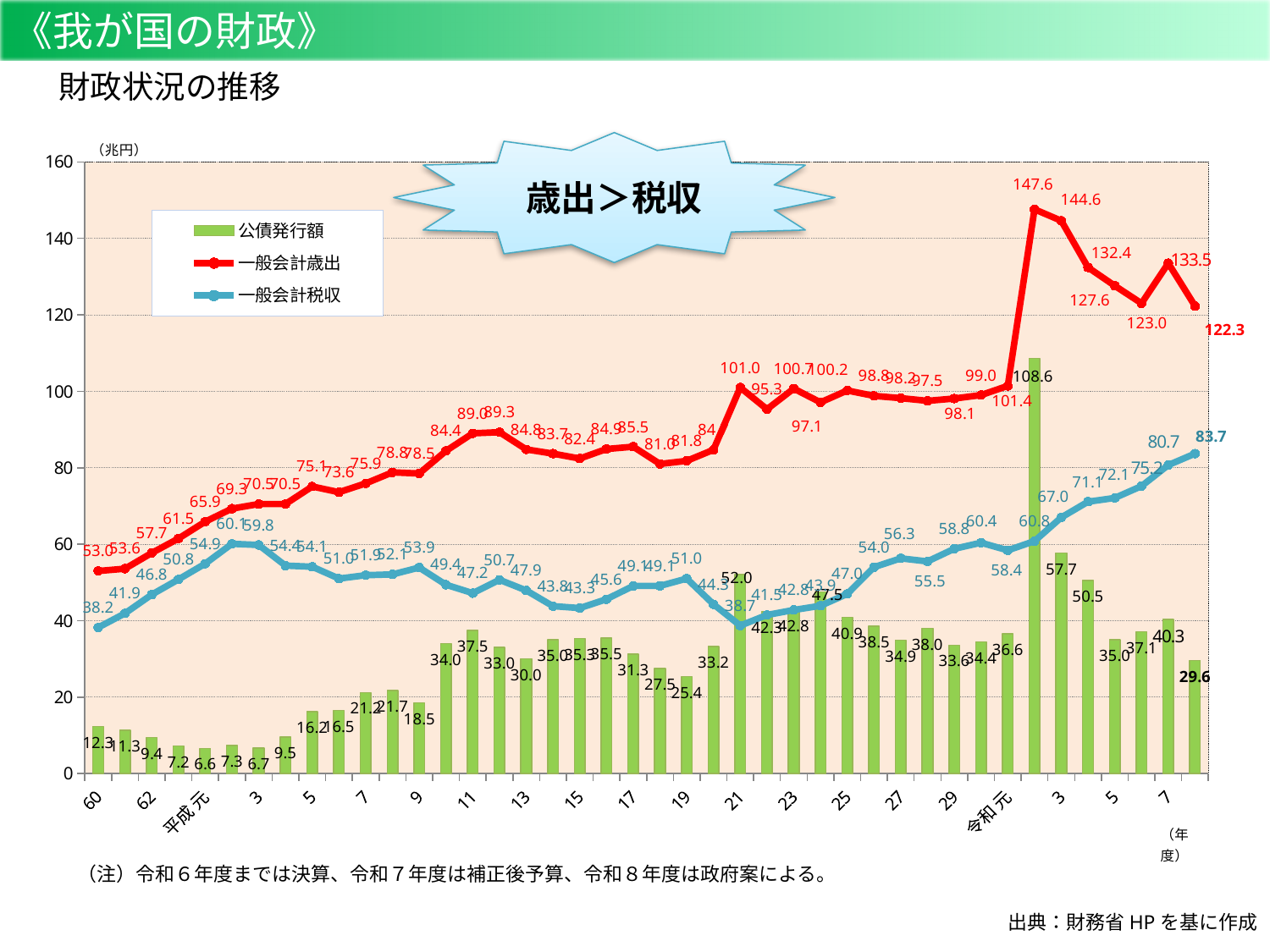
What is the highest value of 公債発行額 shown on the chart? 108.6 Does 一般会計税収 rise or fall from 令和元 to 令和8? rise Is the value of 一般会計歳出 in 令和2 greater or less than 140? greater What are the three series named in the legend? 公債発行額, 一般会計歳出, 一般会計税収 What is the value of 一般会計歳出 at its highest point? 147.6 What kind of chart is shown on the slide? A combined bar and line chart What is the value of 一般会計税収 for the last year on the chart (令和8)? 83.7 What is the lowest value of 公債発行額 shown on the chart? 6.6 Which is larger, 公債発行額 in 令和2 (108.6) or in 令和3 (57.7)? 令和2 (108.6) What is the difference between 一般会計歳出 (122.3) and 一般会計税収 (83.7) in the last year on the chart? 38.6 What is the value of 公債発行額 for the last year on the chart (令和8)? 29.6 How many series does the legend list? 3